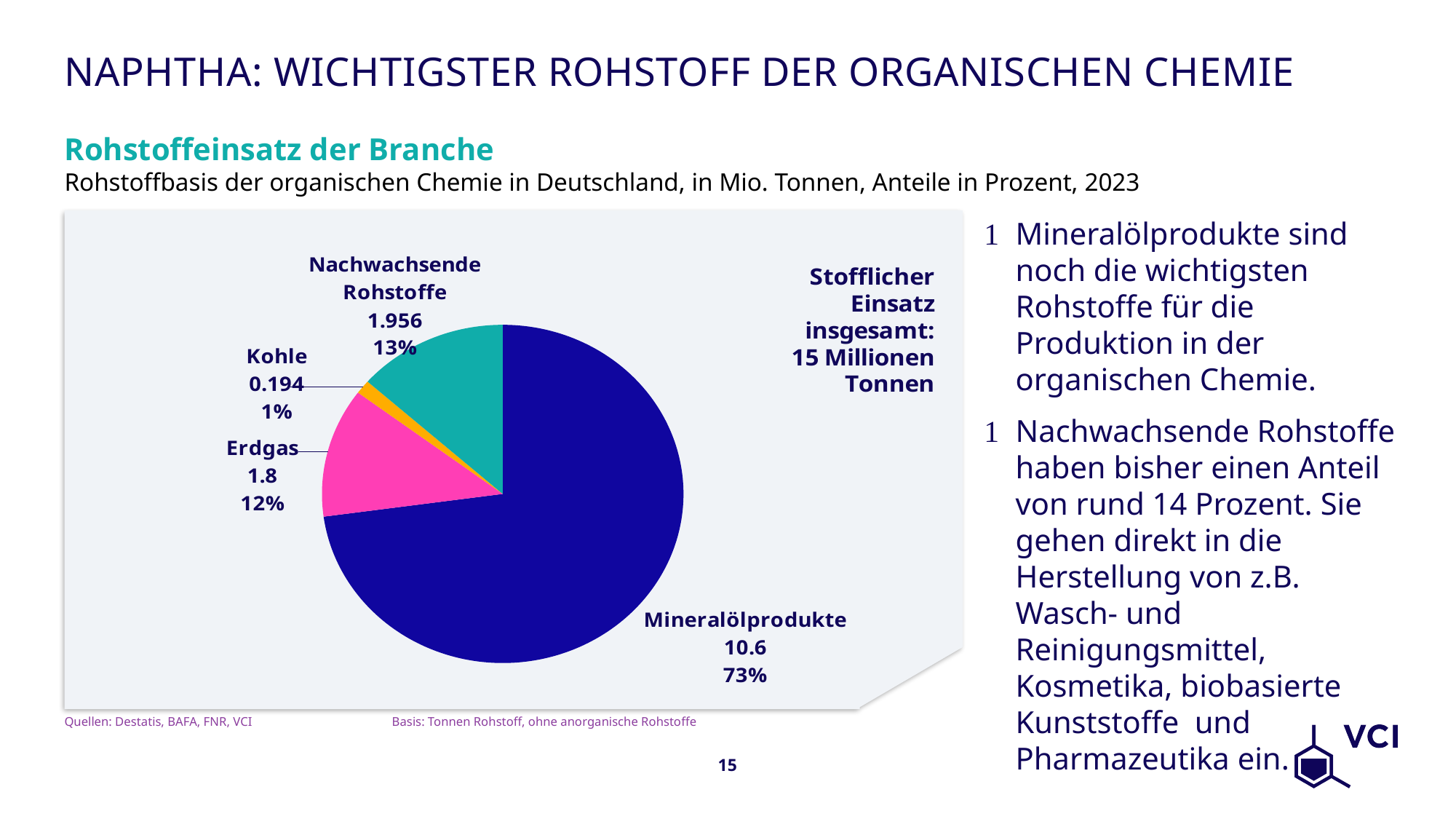
What is the value for Kohle? 0.194 What percentage share does Erdgas have in the pie chart? 12% How many slices does the pie chart have? 4 Which is larger, the slice for Nachwachsende Rohstoffe or the slice for Erdgas? Nachwachsende Rohstoffe Which category has the smallest slice of the pie? Kohle What percentage share does Mineralölprodukte have? 73% What is the title of the chart? Rohstoffeinsatz der Branche What is the value for Mineralölprodukte in the pie chart? 10.6 What is the value for Nachwachsende Rohstoffe? 1.956 What is the difference between the values for Erdgas and Kohle? 1.606 What kind of chart is shown on the slide? pie chart Which category has the largest slice of the pie? Mineralölprodukte